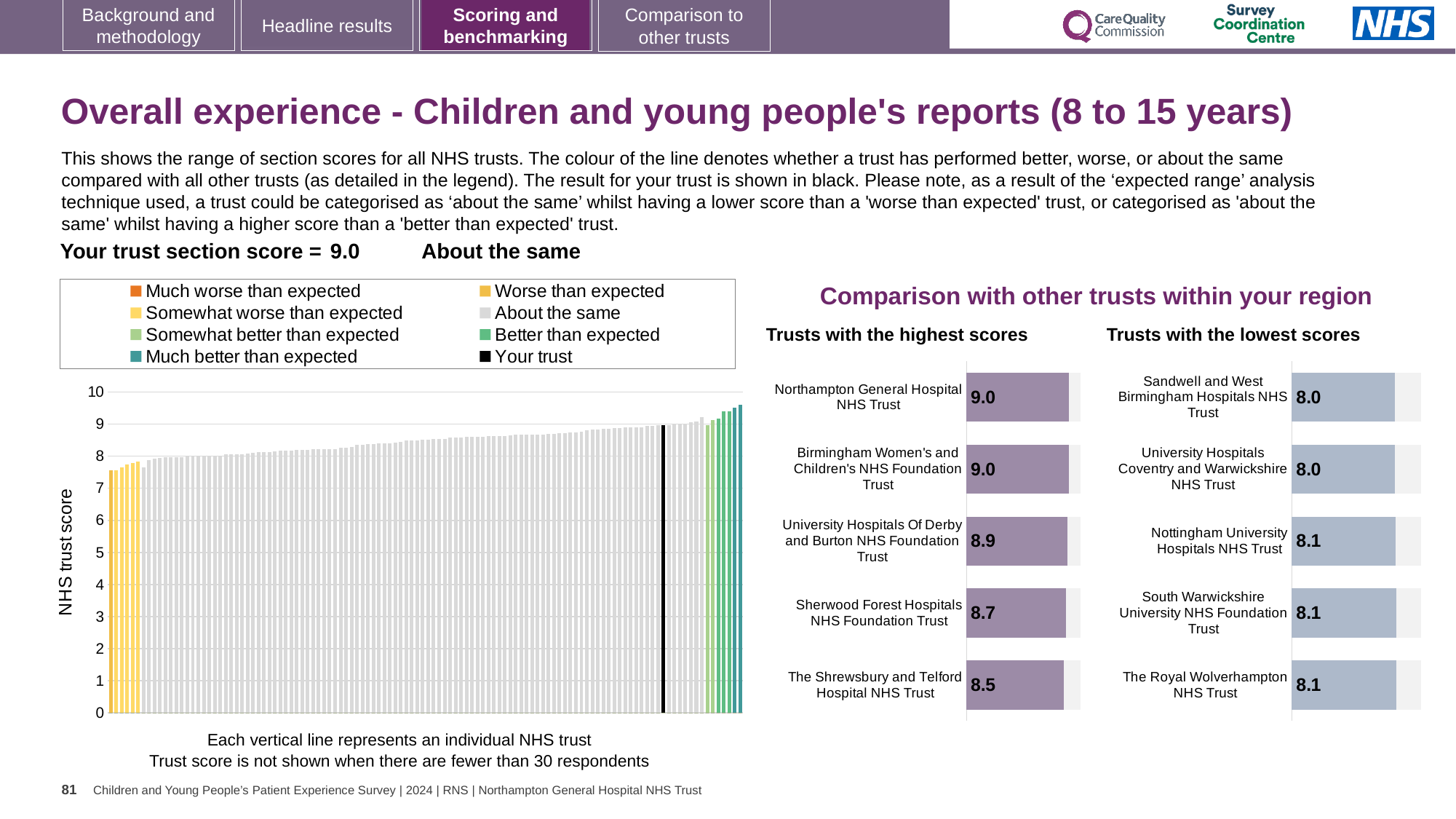
What kind of chart is the large chart on the left showing NHS trust scores? bar chart How many trusts are shown in the 'Trusts with the lowest scores' chart? 5 In the 'Trusts with the highest scores' chart, what is the score for Sherwood Forest Hospitals NHS Foundation Trust? 8.7 In the 'Trusts with the highest scores' chart, which trust has the lowest score? The Shrewsbury and Telford Hospital NHS Trust In the 'Trusts with the lowest scores' chart, what is the score for Nottingham University Hospitals NHS Trust? 8.1 In the left-hand chart, do the trust scores rise or fall from left to right? rise How many entries does the legend above the left-hand chart list? 8 In the 'Trusts with the lowest scores' chart, which has the higher score: Sandwell and West Birmingham Hospitals NHS Trust or Nottingham University Hospitals NHS Trust? Nottingham University Hospitals NHS Trust In the 'Trusts with the highest scores' chart, what is the difference between the scores of University Hospitals Of Derby and Burton NHS Foundation Trust and The Shrewsbury and Telford Hospital NHS Trust? 0.4 What is your trust's section score shown on the slide? 9.0 In the 'Trusts with the highest scores' chart, what is the difference between the scores of Northampton General Hospital NHS Trust and Sherwood Forest Hospitals NHS Foundation Trust? 0.3 In the left-hand chart, is the value of the leftmost bar greater or less than 8? less